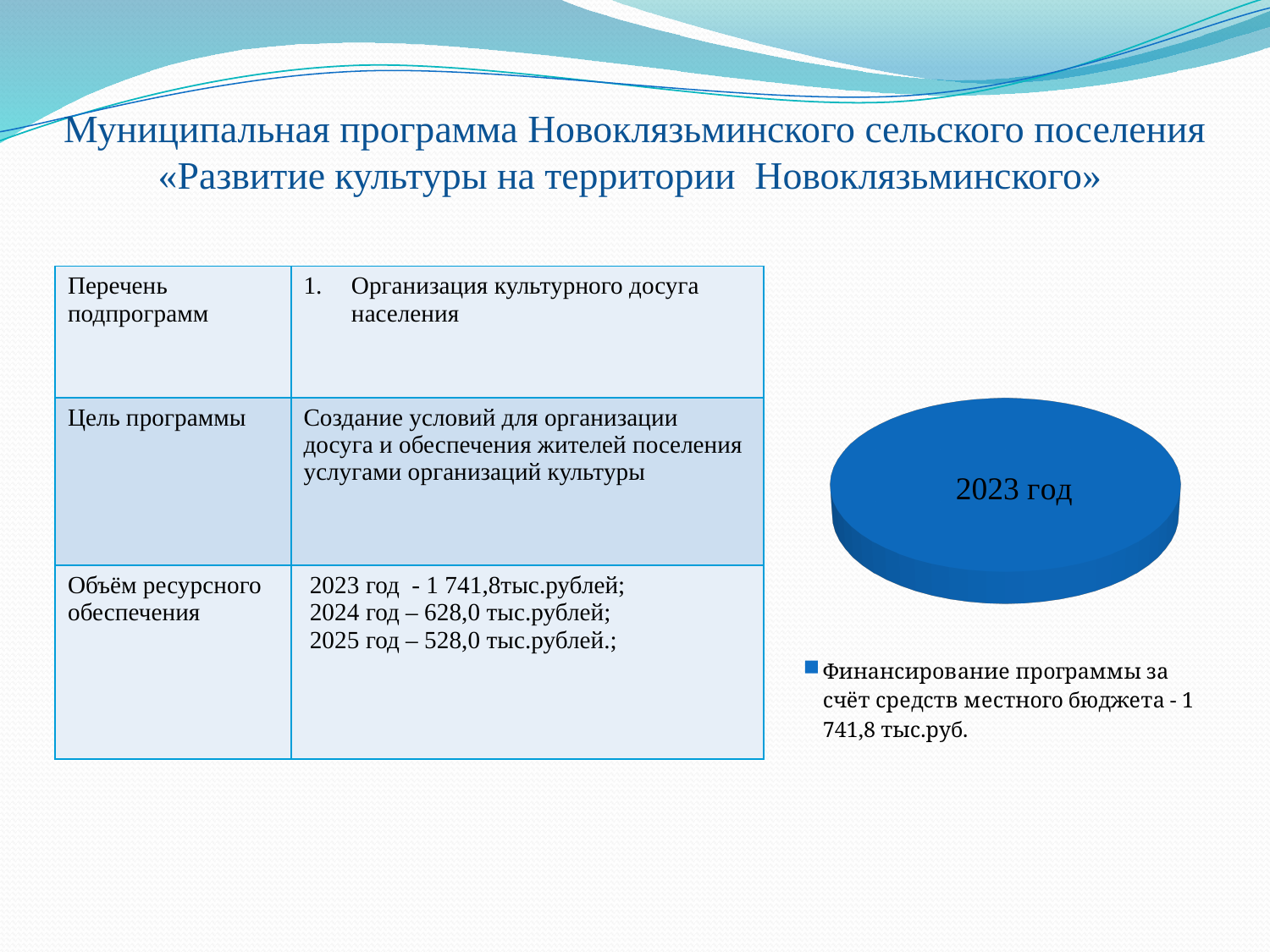
How many entries does the legend of the pie chart list? 1 What share of the pie does the slice labelled "2023 год" represent? 100% How many slices does the pie chart contain? 1 What amount does the legend of the pie chart give for financing the programme from the local budget? 1 741,8 тыс.руб. What kind of chart is shown on the right side of the slide? pie chart What colour is the slice of the pie chart? blue What label is printed on the single slice of the pie chart? 2023 год